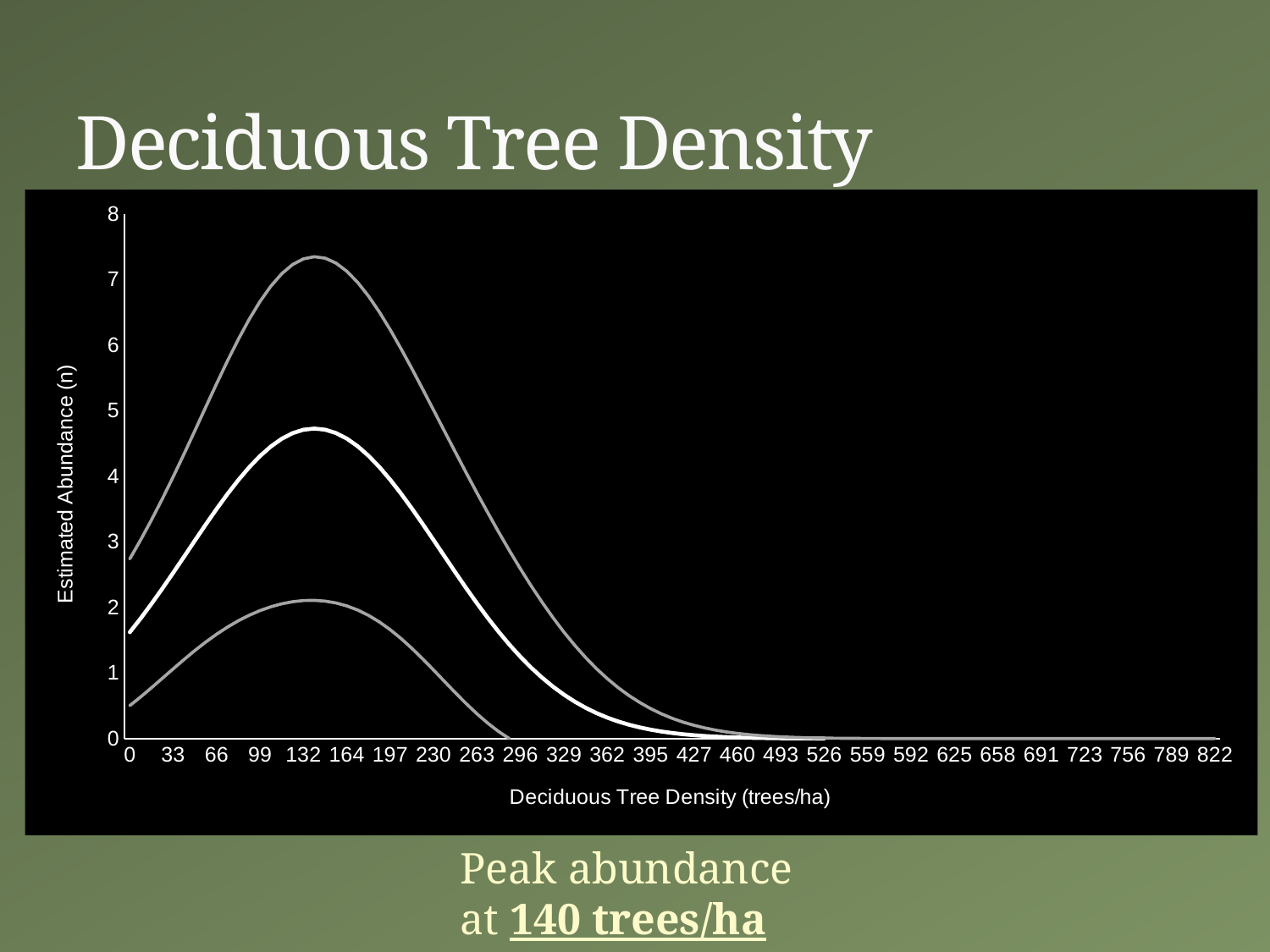
What is the title of the chart's x axis? Deciduous Tree Density (trees/ha) Is the peak value of the upper line greater or less than 7? greater What kind of chart is shown on the slide? line chart Is the value of the middle (white) line at a density of 0 greater or less than 2? less Is the peak value of the middle (white) line greater or less than 4? greater What is the title of the chart's y axis? Estimated Abundance (n) Do the lines rise or fall as density increases from 164 to 395 trees/ha? fall What is the highest tick label shown on the x axis? 822 How many lines are plotted on the chart? 3